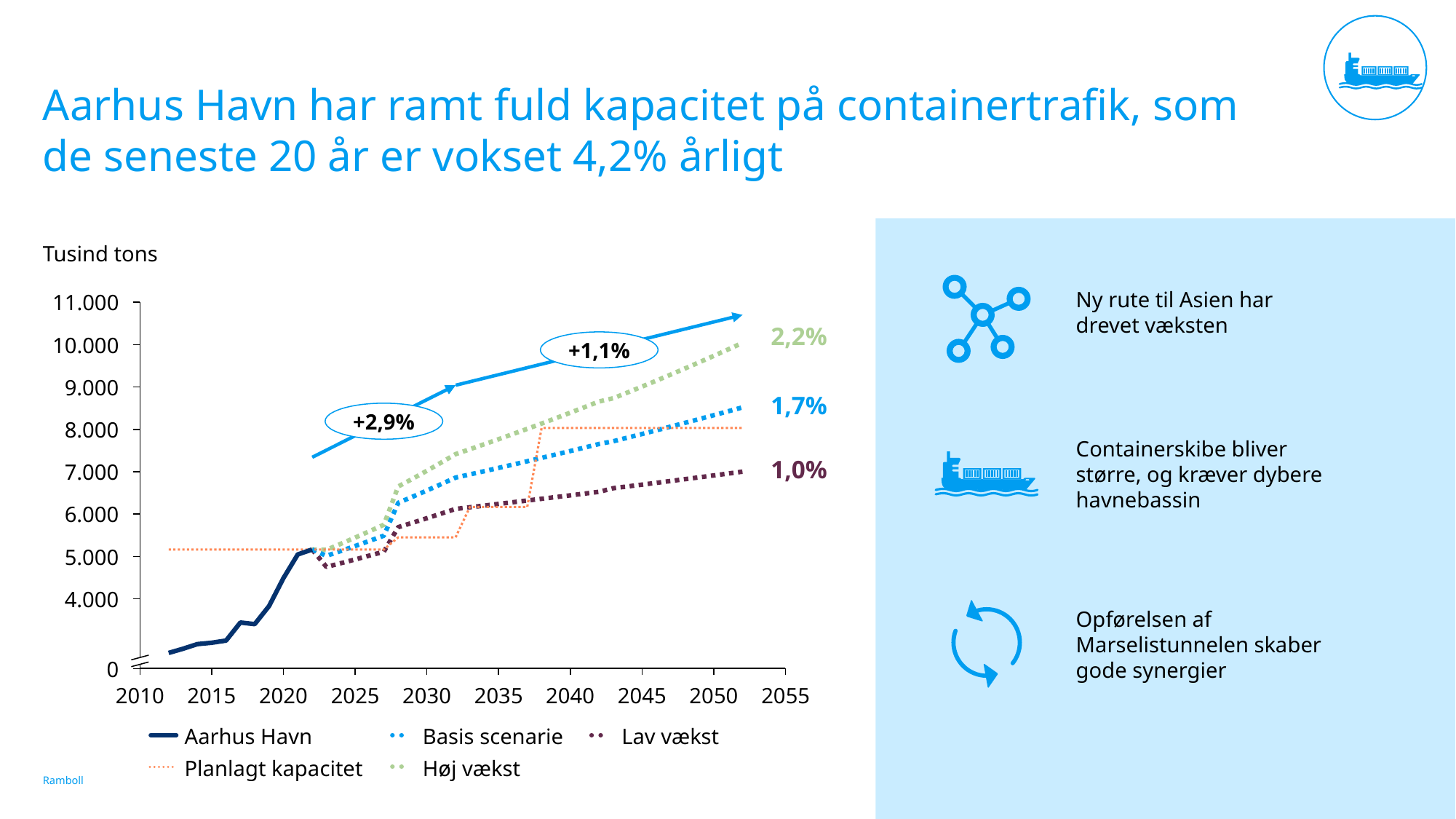
At 2050, which is larger: Basis scenarie or Lav vækst? Basis scenarie What annual growth rate is labelled next to the Lav vækst line at the right of the chart? 1,0% Does the Aarhus Havn series rise or fall between 2012 and 2022? rise What annual growth rate is labelled next to the Høj vækst line at the right of the chart? 2,2% What unit is shown above the y axis of the chart? Tusind tons Is the value for Aarhus Havn in 2012 greater or less than 4.000? less How many series does the chart legend list? 5 Which series reaches the highest value at the right end of the chart? Høj vækst Which of the three scenario series is lowest at the right end of the chart? Lav vækst Is the value for Lav vækst in 2050 greater or less than 6.000? greater What kind of chart is shown on the slide? line chart Is the value for Høj vækst in 2050 greater or less than 9.000? greater